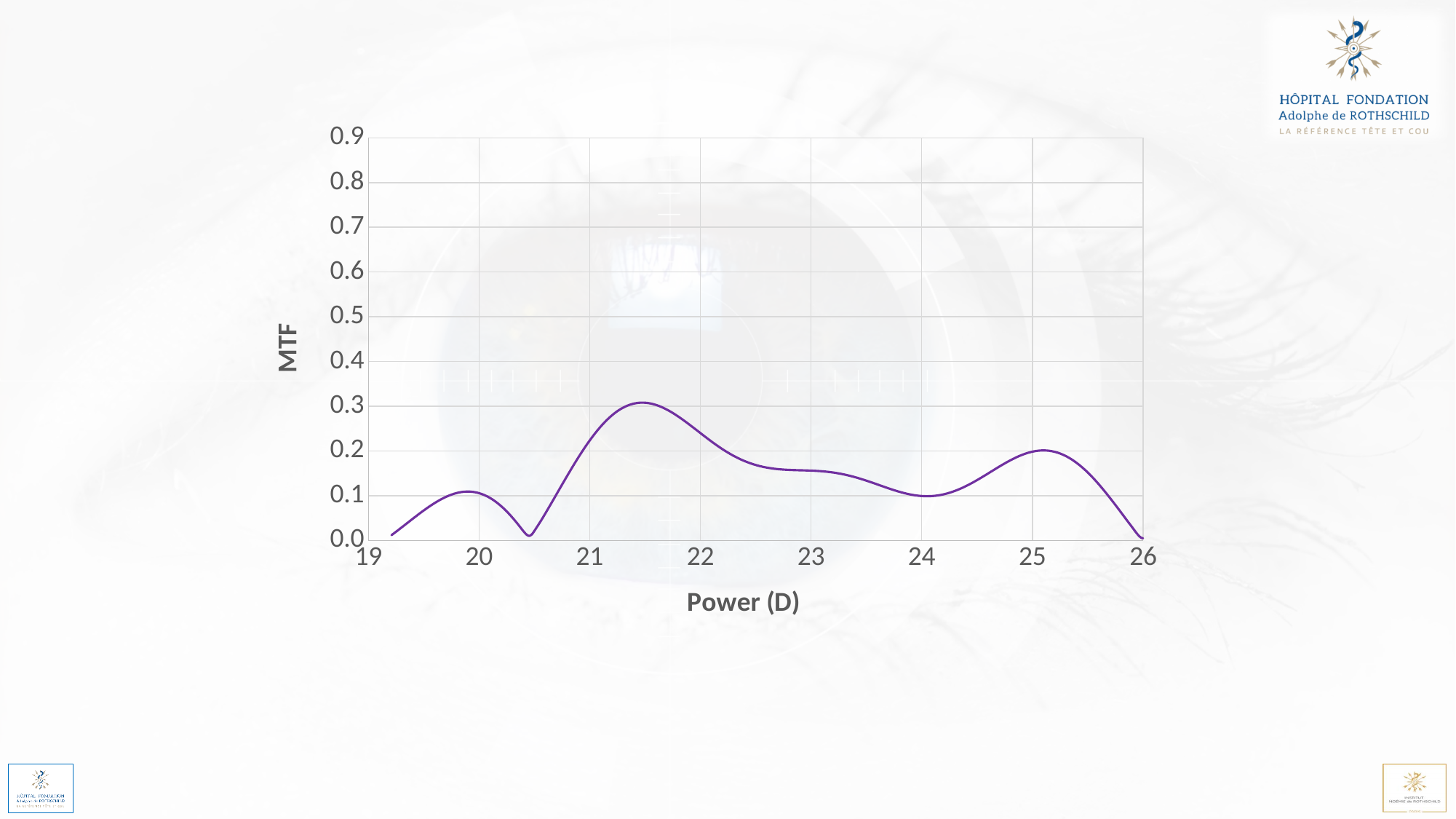
Is the MTF value at a power of 22 D greater or less than 0.3? less What is the label of the y axis? MTF What is the label of the x axis? Power (D) Is the highest MTF value on the curve greater or less than 0.4? less Is the MTF value at a power of 23 D greater or less than 0.1? greater What kind of chart is shown on the slide? line chart Which has the larger MTF value: a power of 22 D or a power of 24 D? 22 D Which has the larger MTF value: a power of 20 D or a power of 22 D? 22 D Does the MTF rise or fall as power increases from 22 D to 24 D? fall Does the MTF rise or fall as power increases from 24 D to 25 D? rise